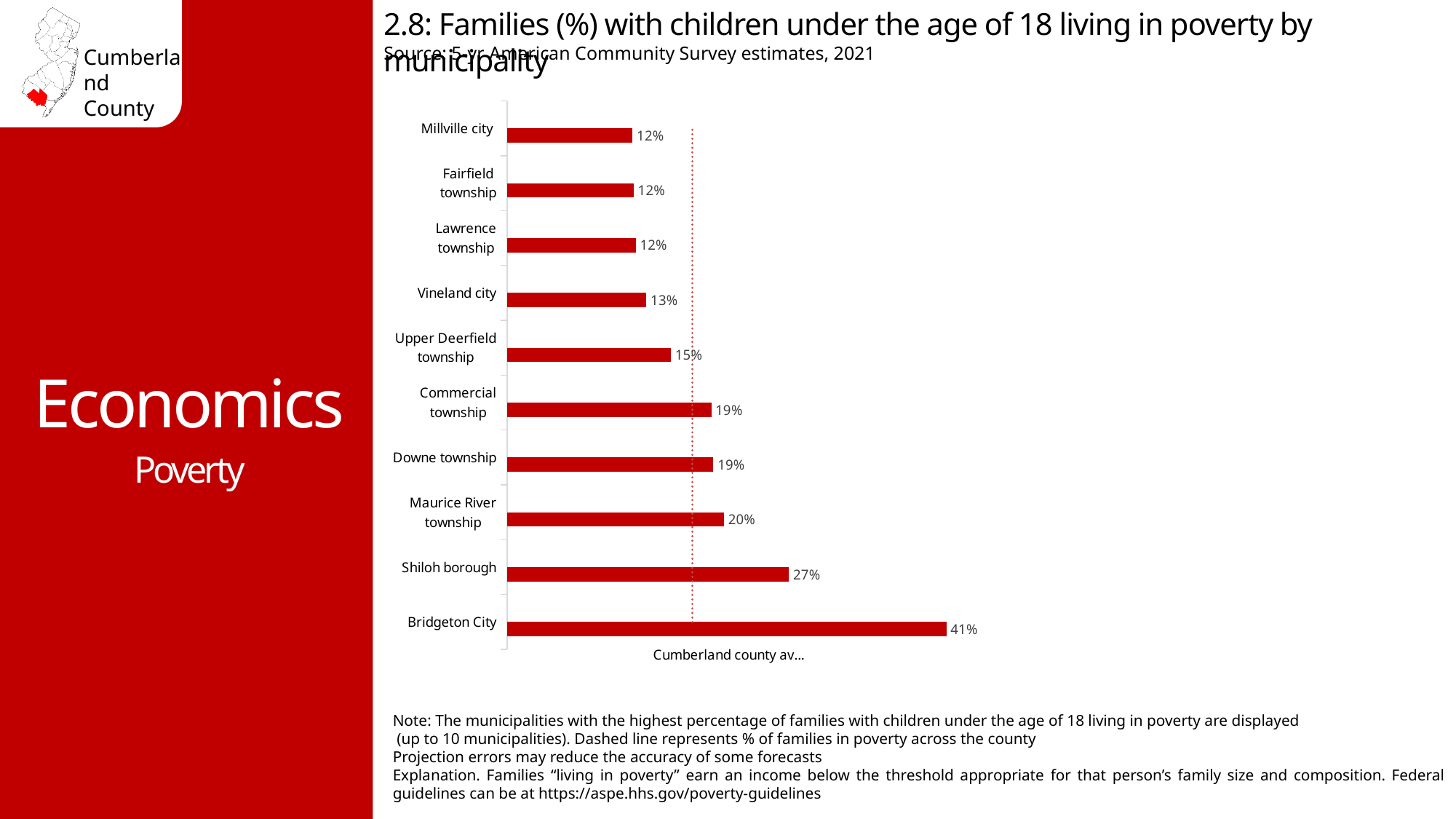
How many municipalities are shown in the chart? 10 What type of chart is used on this slide? Bar chart Which has a higher value, Shiloh borough or Maurice River township? Shiloh borough What is the difference in percentage points between Maurice River township and Vineland city? 7 What does the dotted vertical line in the chart represent? Cumberland county average Which has a higher value, Commercial township or Upper Deerfield township? Commercial township What is the difference in percentage points between Bridgeton City and Shiloh borough? 14 What percentage of families with children under 18 live in poverty in Bridgeton City? 41% What is the value shown for Vineland city? 13% Which municipality has the highest percentage of families with children under 18 living in poverty? Bridgeton City What is the value shown for Shiloh borough? 27% What is the value shown for Upper Deerfield township? 15%